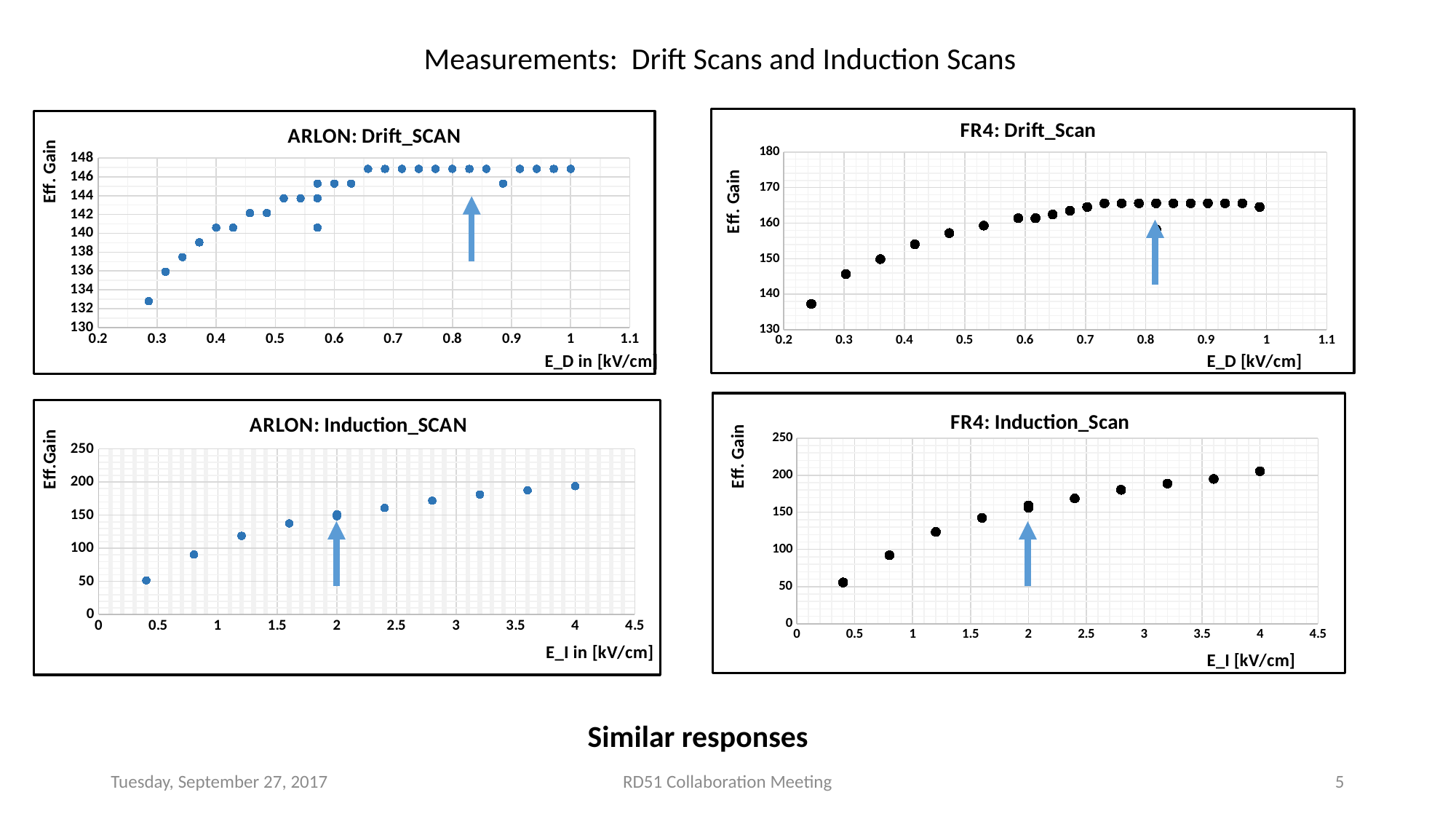
What is the x-axis title of the FR4: Drift_Scan chart? E_D [kV/cm] In the FR4: Induction_Scan chart, do the values rise or fall as E_I increases? rise In the FR4: Drift_Scan chart, is the value at the lowest E_D point greater or less than 140? less In the ARLON: Induction_SCAN chart, is the value at E_I = 4 greater or less than 150? greater What kind of chart is the ARLON: Drift_SCAN chart? scatter chart In the ARLON: Induction_SCAN chart, do the values rise or fall as E_I increases? rise In the ARLON: Induction_SCAN chart, is the value at E_I = 0.4 greater or less than 100? less In the FR4: Induction_Scan chart, which has the larger effective gain: E_I = 0.4 or E_I = 4? E_I = 4 In the ARLON: Induction_SCAN chart, at which E_I value is the effective gain highest? 4